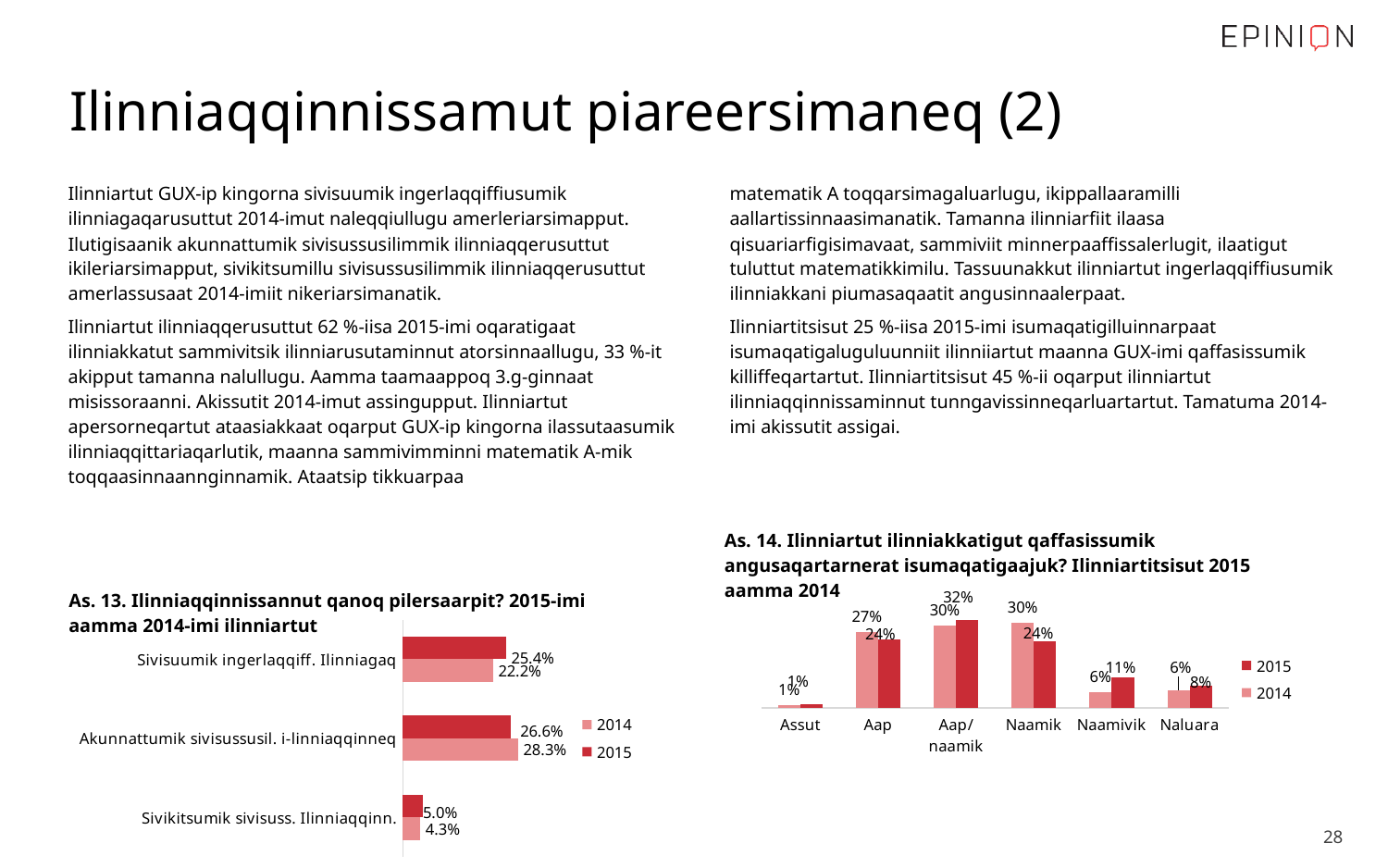
In the chart 'As. 14. Ilinniartut ilinniakkatigut qaffasissumik angusaqartarnerat isumaqatigaajuk?', what is the difference between the 2015 and 2014 values for 'Naamivik'? 5% In the chart 'As. 13. Ilinniaqqinnissannut qanoq pilersaarpit?', what is the 2015 value for 'Sivisuumik ingerlaqqiff. Ilinniagaq'? 25.4% What type of chart is 'As. 13. Ilinniaqqinnissannut qanoq pilersaarpit?'? Bar chart In the chart 'As. 13. Ilinniaqqinnissannut qanoq pilersaarpit?', which category has the lowest 2015 value? Sivikitsumik sivisuss. Ilinniaqqinn. In the chart 'As. 14. Ilinniartut ilinniakkatigut qaffasissumik angusaqartarnerat isumaqatigaajuk?', what is the 2014 value for 'Naamik'? 30% In the chart 'As. 13. Ilinniaqqinnissannut qanoq pilersaarpit?', what is the difference between the 2015 and 2014 values for 'Sivisuumik ingerlaqqiff. Ilinniagaq'? 3.2% In the chart 'As. 14. Ilinniartut ilinniakkatigut qaffasissumik angusaqartarnerat isumaqatigaajuk?', what is the 2015 value for 'Aap/naamik'? 32% In the chart 'As. 14. Ilinniartut ilinniakkatigut qaffasissumik angusaqartarnerat isumaqatigaajuk?', is the 2014 value for 'Aap' or the 2015 value for 'Aap' larger? 2014 In the chart 'As. 14. Ilinniartut ilinniakkatigut qaffasissumik angusaqartarnerat isumaqatigaajuk?', which category has the highest 2015 value? Aap/naamik How many series does the legend of the chart 'As. 14. Ilinniartut ilinniakkatigut qaffasissumik angusaqartarnerat isumaqatigaajuk?' list? 2 In the chart 'As. 13. Ilinniaqqinnissannut qanoq pilersaarpit?', what is the 2014 value for 'Akunnattumik sivisussusil. i-linniaqqinneq'? 28.3% In the chart 'As. 13. Ilinniaqqinnissannut qanoq pilersaarpit?', how many categories are shown? 3